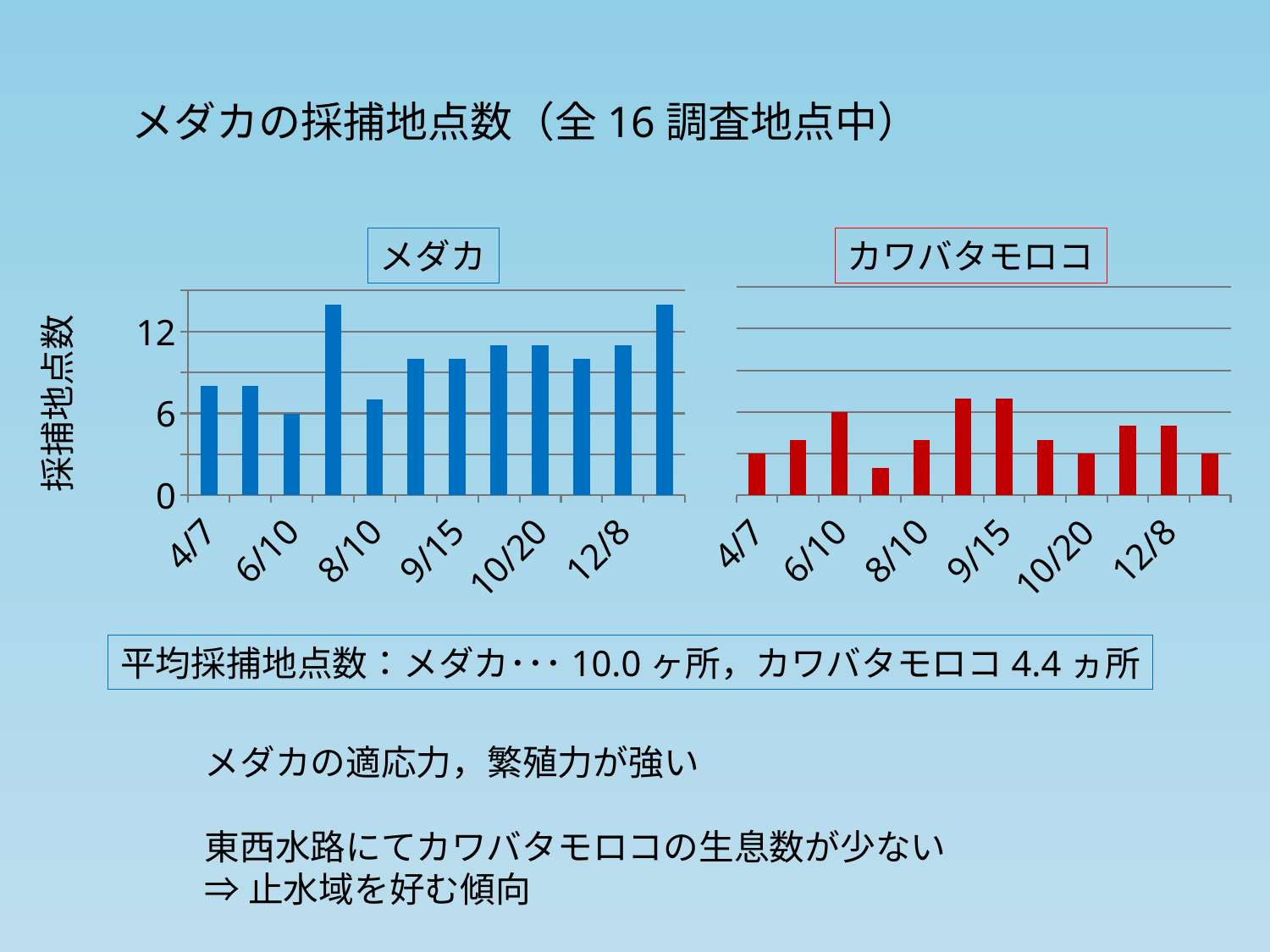
In the カワバタモロコ chart, is the value for 9/15 greater or less than 6? greater What kind of chart is the メダカ chart? bar chart In the メダカ chart, is the value for 12/8 greater or less than 6? greater In the カワバタモロコ chart, how many bars are plotted? 12 What is the label on the vertical axis shared by the two charts? 採捕地点数 In the メダカ chart, how many bars are plotted? 12 In the カワバタモロコ chart, is the value for 4/7 greater or less than 6? less Comparing the two charts, which species has the larger value for 4/7, メダカ or カワバタモロコ? メダカ In the メダカ chart, which is larger, the value for 6/10 or the value for 12/8? 12/8 In the カワバタモロコ chart, which is larger, the value for 4/7 or the value for 6/10? 6/10